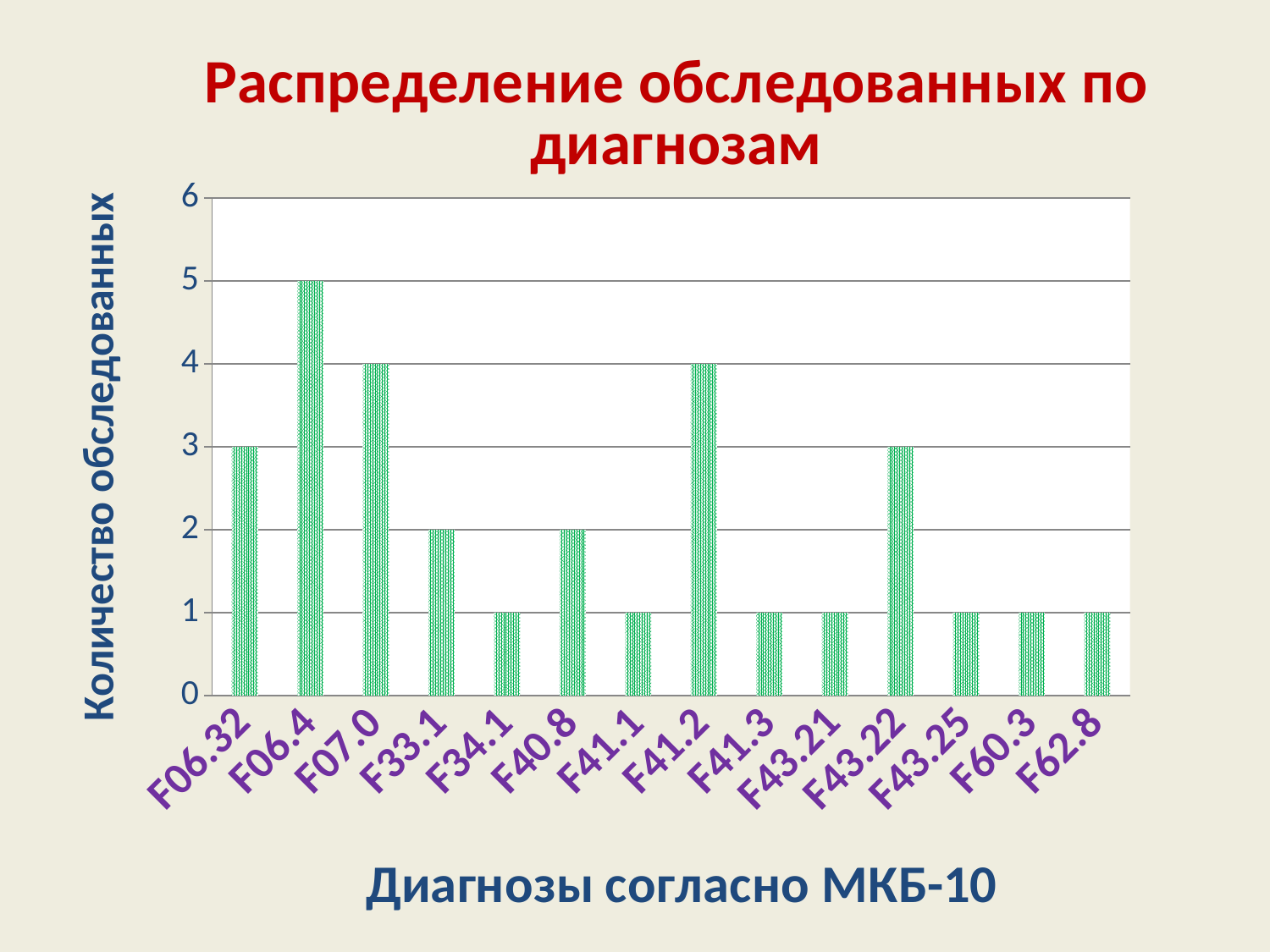
What is the label of the x axis? Диагнозы согласно МКБ-10 What is the value for F33.1? 2 What is the value for F07.0? 4 Which is larger, the value for F41.2 or the value for F40.8? F41.2 Which diagnosis has the highest number of examined patients? F06.4 What is the value for F43.22? 3 Is the value for F06.4 greater or less than 4? greater What is the difference between the values for F06.4 and F06.32? 2 What is the title of the chart? Распределение обследованных по диагнозам What type of chart is shown on the slide? bar chart What is the value for F06.4? 5 How many diagnosis categories are shown on the x axis? 14